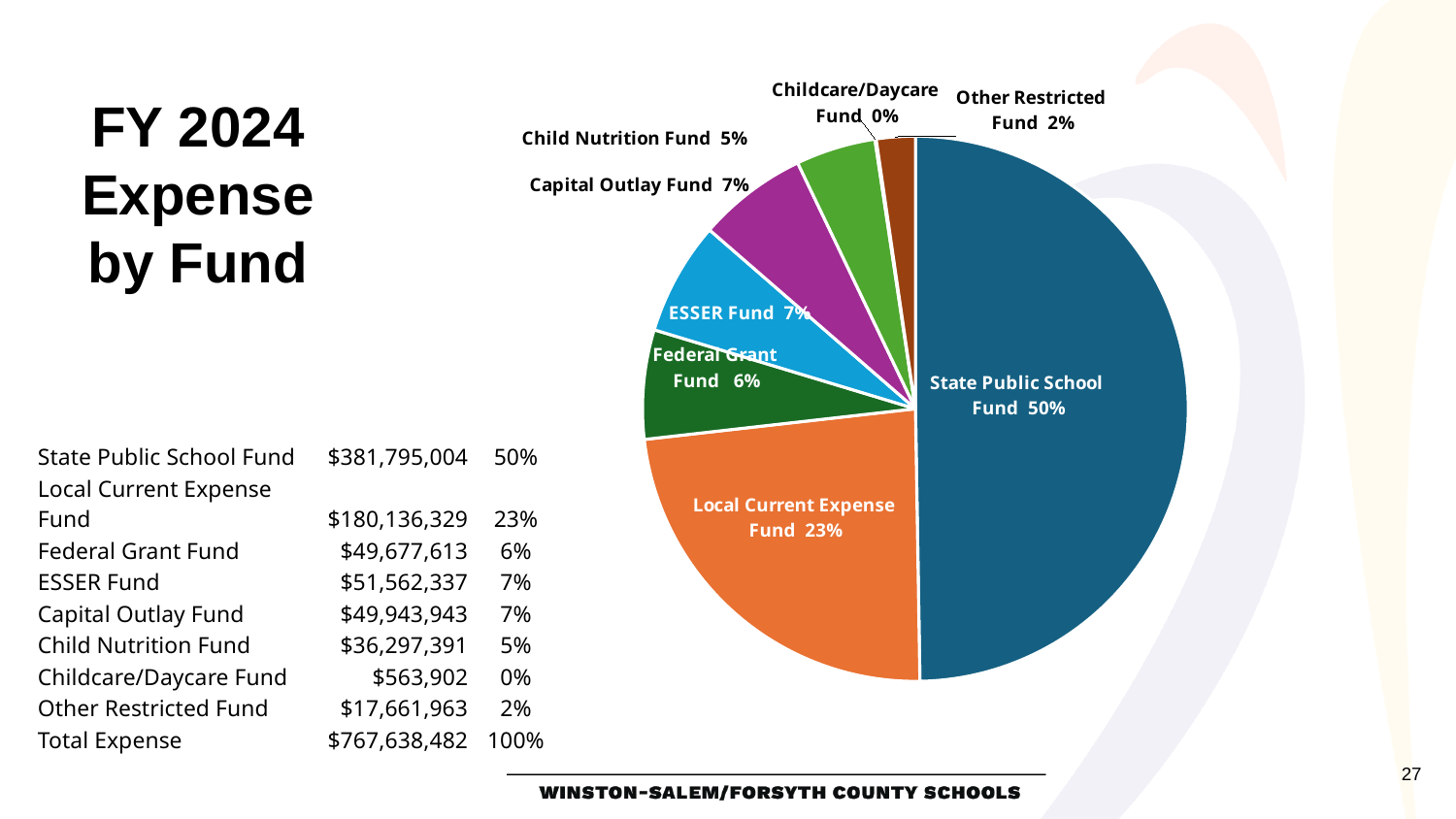
What percentage is shown for the Other Restricted Fund? 2% Which fund has the smallest slice of the pie? Childcare/Daycare Fund Which is larger, the Federal Grant Fund share or the Child Nutrition Fund share? Federal Grant Fund What is the title of the slide's chart? FY 2024 Expense by Fund What kind of chart is shown on the slide? pie chart What percentage is shown for the Local Current Expense Fund? 23% What share of the pie does the State Public School Fund represent? 50% Which fund has the largest slice of the pie? State Public School Fund By how many percentage points does the State Public School Fund share exceed the Local Current Expense Fund share? 27 What percentage is shown for the Capital Outlay Fund? 7% According to the table on the slide, what is the dollar amount for the State Public School Fund? $381,795,004 How many slices does the pie chart have? 8